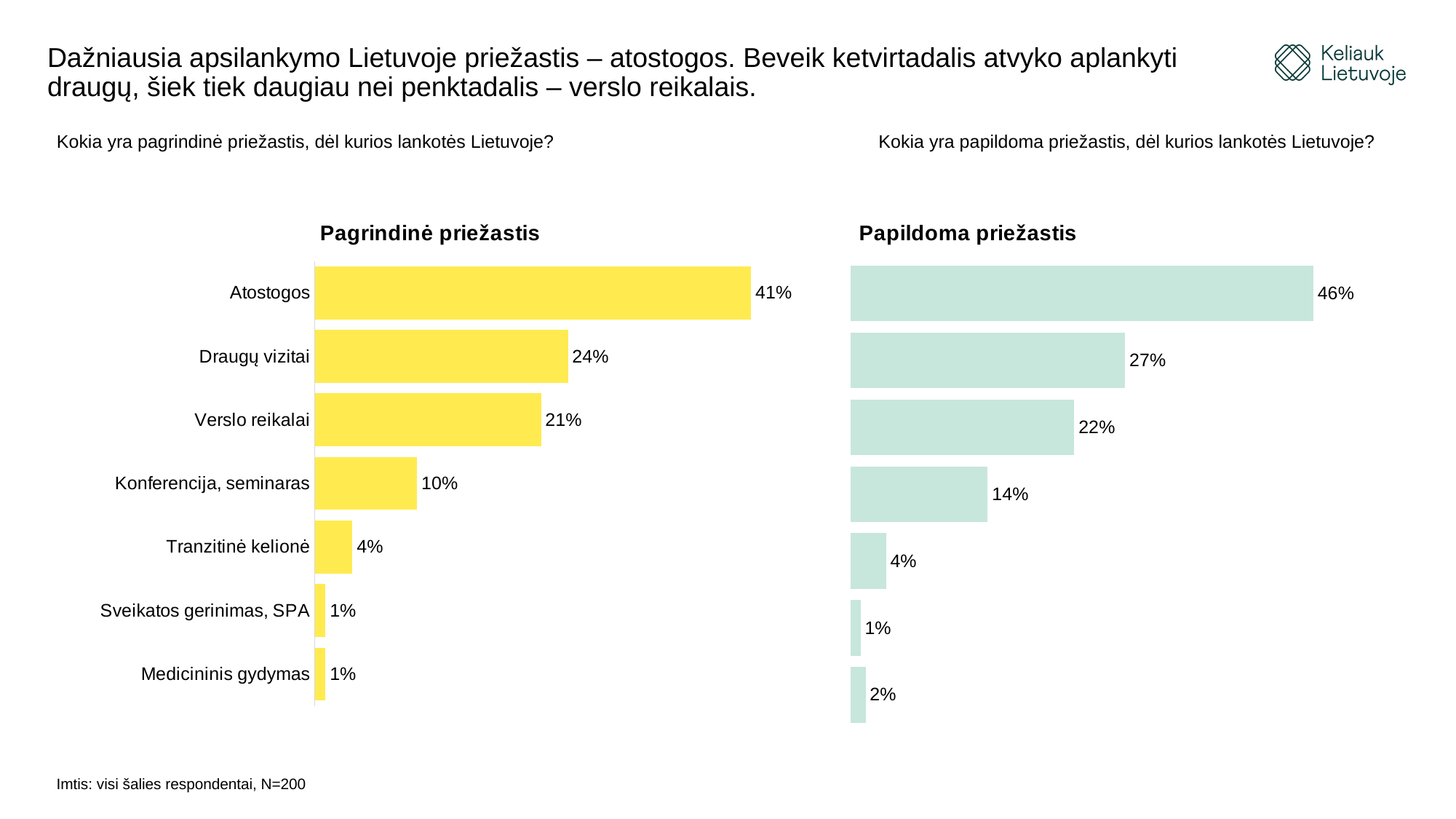
What type of chart is 'Papildoma priežastis'? Bar chart What colour are the bars in the 'Pagrindinė priežastis' chart? Yellow In the 'Pagrindinė priežastis' chart, which is larger: Verslo reikalai or Konferencija, seminaras? Verslo reikalai In the 'Pagrindinė priežastis' chart, which category has the highest value? Atostogos In the 'Papildoma priežastis' chart, what is the value of the top bar (the Atostogos row)? 46% In the 'Pagrindinė priežastis' chart, what is the value for Atostogos? 41% In the 'Pagrindinė priežastis' chart, what is the value for Konferencija, seminaras? 10% In the 'Papildoma priežastis' chart, what is the value of the smallest bar? 1% In the 'Pagrindinė priežastis' chart, what is the difference between Draugų vizitai and Verslo reikalai? 3% In the 'Papildoma priežastis' chart, what is the difference between the top bar (46%) and the second bar (27%)? 19% How many categories are shown in the 'Pagrindinė priežastis' chart? 7 In the 'Papildoma priežastis' chart, what is the value of the fourth bar from the top (the Konferencija, seminaras row)? 14%